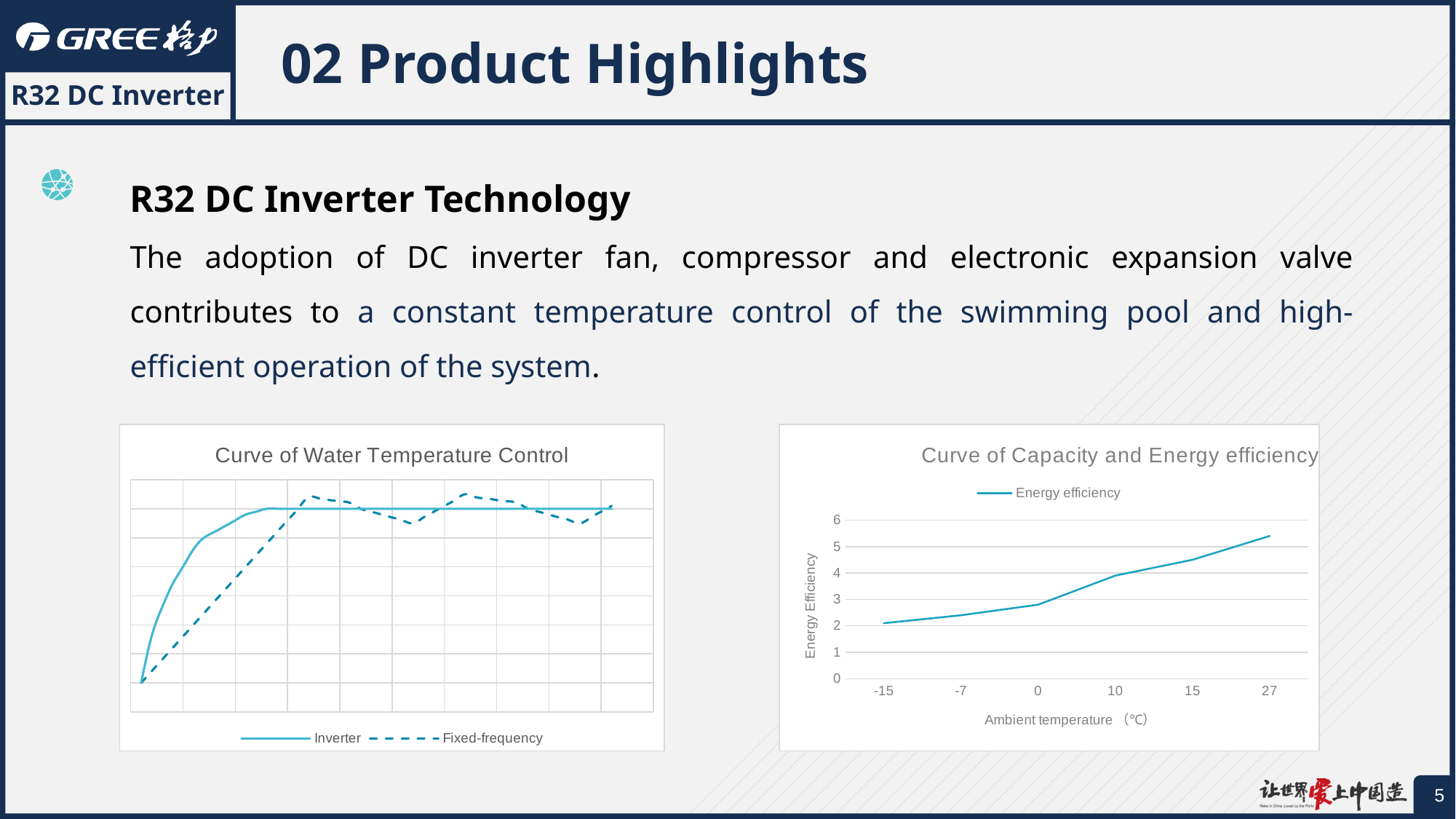
In the 'Curve of Capacity and Energy efficiency' chart, is the energy efficiency at 27°C greater or less than 5? greater In the 'Curve of Capacity and Energy efficiency' chart, which ambient temperature has the lowest energy efficiency? -15 In the 'Curve of Capacity and Energy efficiency' chart, is the energy efficiency at 15°C greater or less than 4? greater How many series does the legend of the 'Curve of Capacity and Energy efficiency' chart list? 1 What is the x-axis title of the 'Curve of Capacity and Energy efficiency' chart? Ambient temperature (℃) In the 'Curve of Capacity and Energy efficiency' chart, how many ambient temperature points are shown on the x axis? 6 How many series does the legend of the 'Curve of Water Temperature Control' chart list? 2 In the 'Curve of Capacity and Energy efficiency' chart, is the energy efficiency at -7°C greater or less than 3? less In the 'Curve of Capacity and Energy efficiency' chart, does energy efficiency rise or fall as ambient temperature increases? rise What type of chart is the 'Curve of Water Temperature Control' chart? line chart What type of chart is the 'Curve of Capacity and Energy efficiency' chart? line chart In the 'Curve of Capacity and Energy efficiency' chart, which ambient temperature has the highest energy efficiency? 27